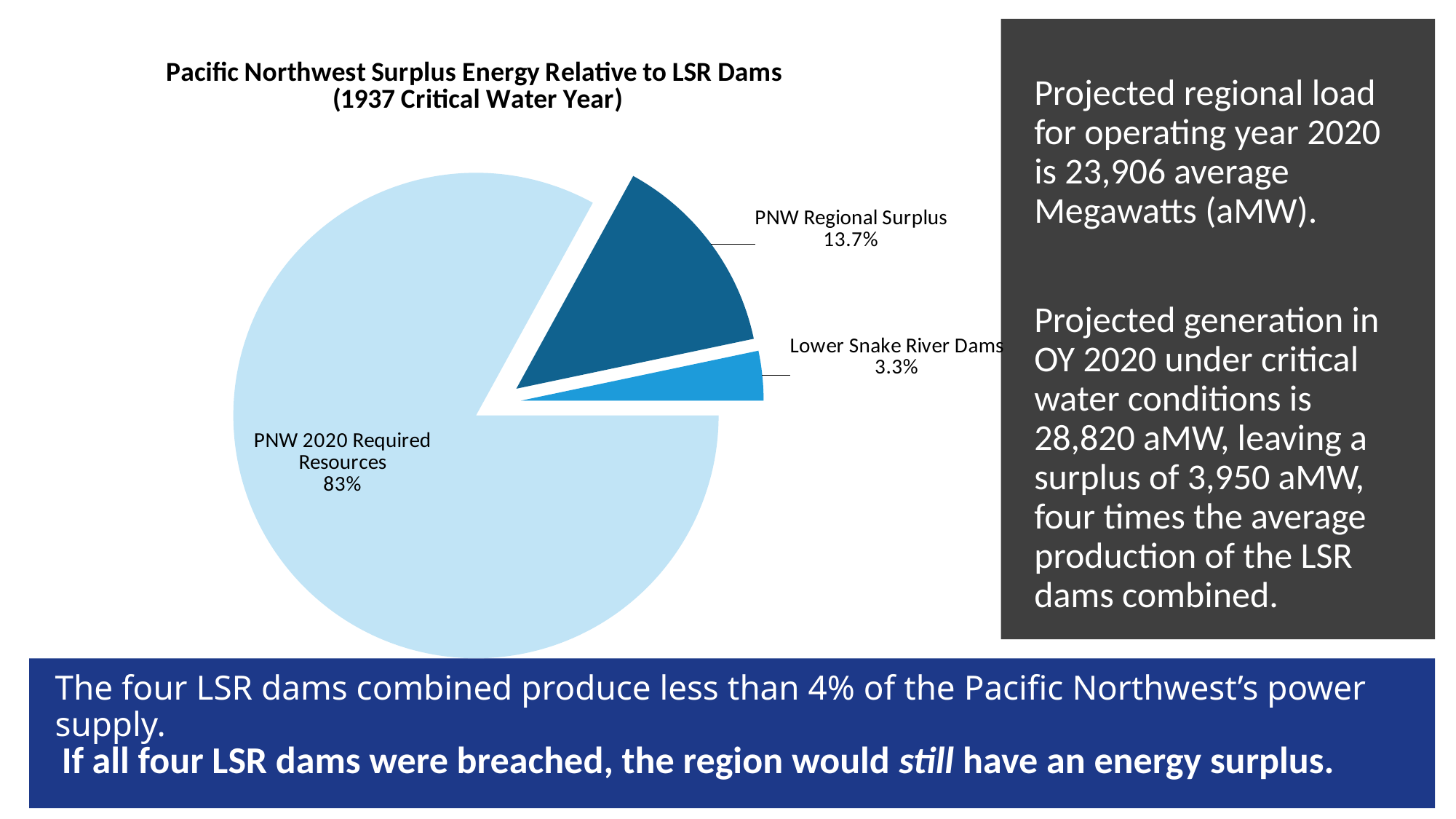
Which slice of the pie is shown in the lightest blue colour? PNW 2020 Required Resources How many slices does the pie chart have? 3 What is the title of the chart? Pacific Northwest Surplus Energy Relative to LSR Dams (1937 Critical Water Year) What is the difference in percentage points between the PNW Regional Surplus slice and the Lower Snake River Dams slice? 10.4 Which slice of the pie is the largest? PNW 2020 Required Resources What share of the pie is Lower Snake River Dams? 3.3% What kind of chart is shown on the slide? pie chart What is the difference in percentage points between the PNW 2020 Required Resources slice and the PNW Regional Surplus slice? 69.3 What share of the pie is PNW 2020 Required Resources? 83% Which slice of the pie is the smallest? Lower Snake River Dams What share of the pie is PNW Regional Surplus? 13.7% Which is larger, the PNW Regional Surplus slice or the Lower Snake River Dams slice? PNW Regional Surplus